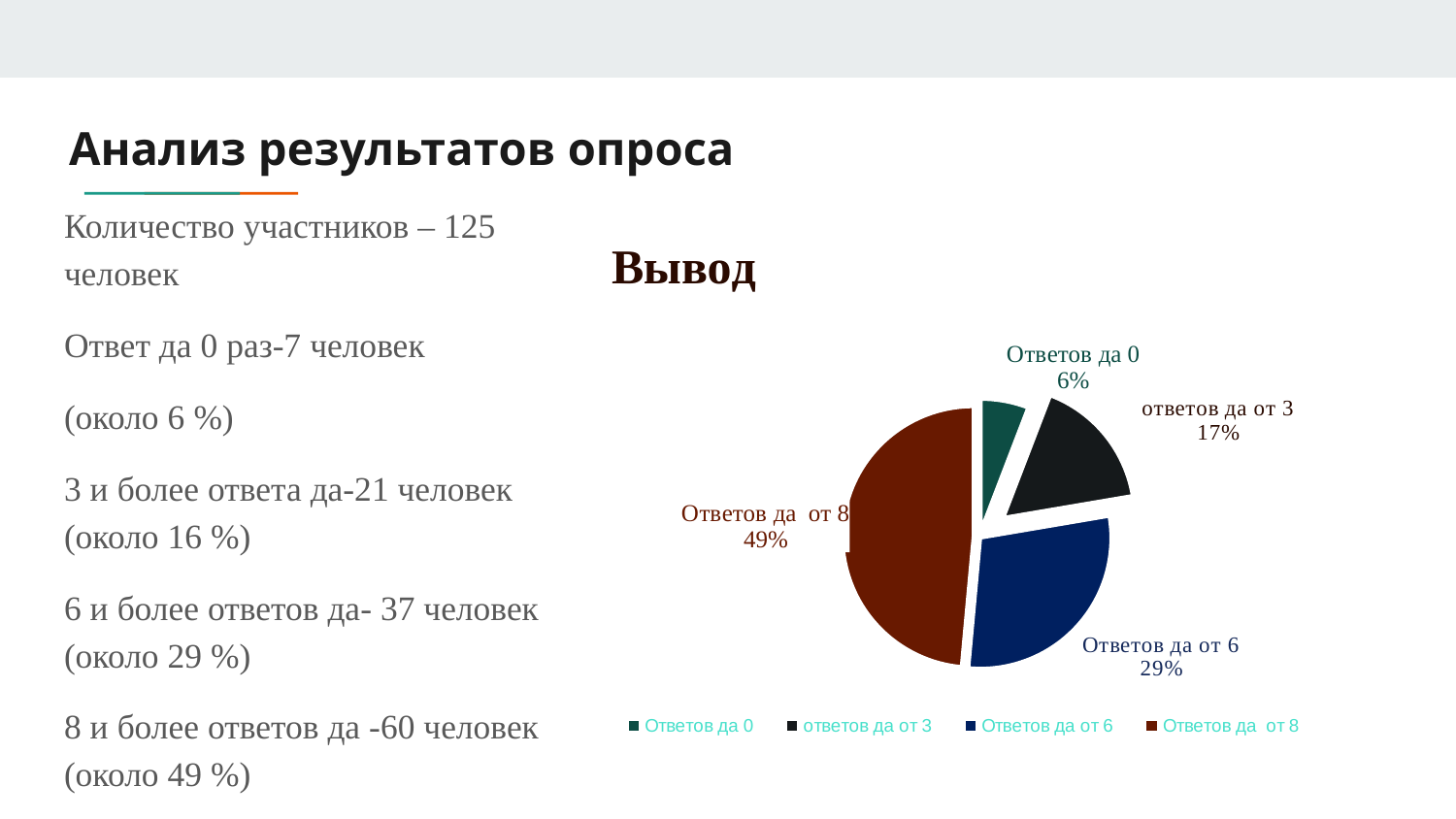
Which slice is larger: "ответов да от 3" or "Ответов да от 6"? Ответов да от 6 Which slice of the pie chart is the largest? Ответов да от 8 What is the difference in percentage points between the "Ответов да от 8" slice and the "Ответов да от 6" slice? 20 How many slices does the pie chart have? 4 What share of the pie does the slice "Ответов да от 8" represent? 49% What kind of chart is shown on the slide? pie chart What share of the pie does the slice "Ответов да 0" represent? 6% Which slice of the pie chart is the smallest? Ответов да 0 What share of the pie does the slice "ответов да от 3" represent? 17% What is the title shown above the pie chart? Вывод How many entries does the legend of the pie chart list? 4